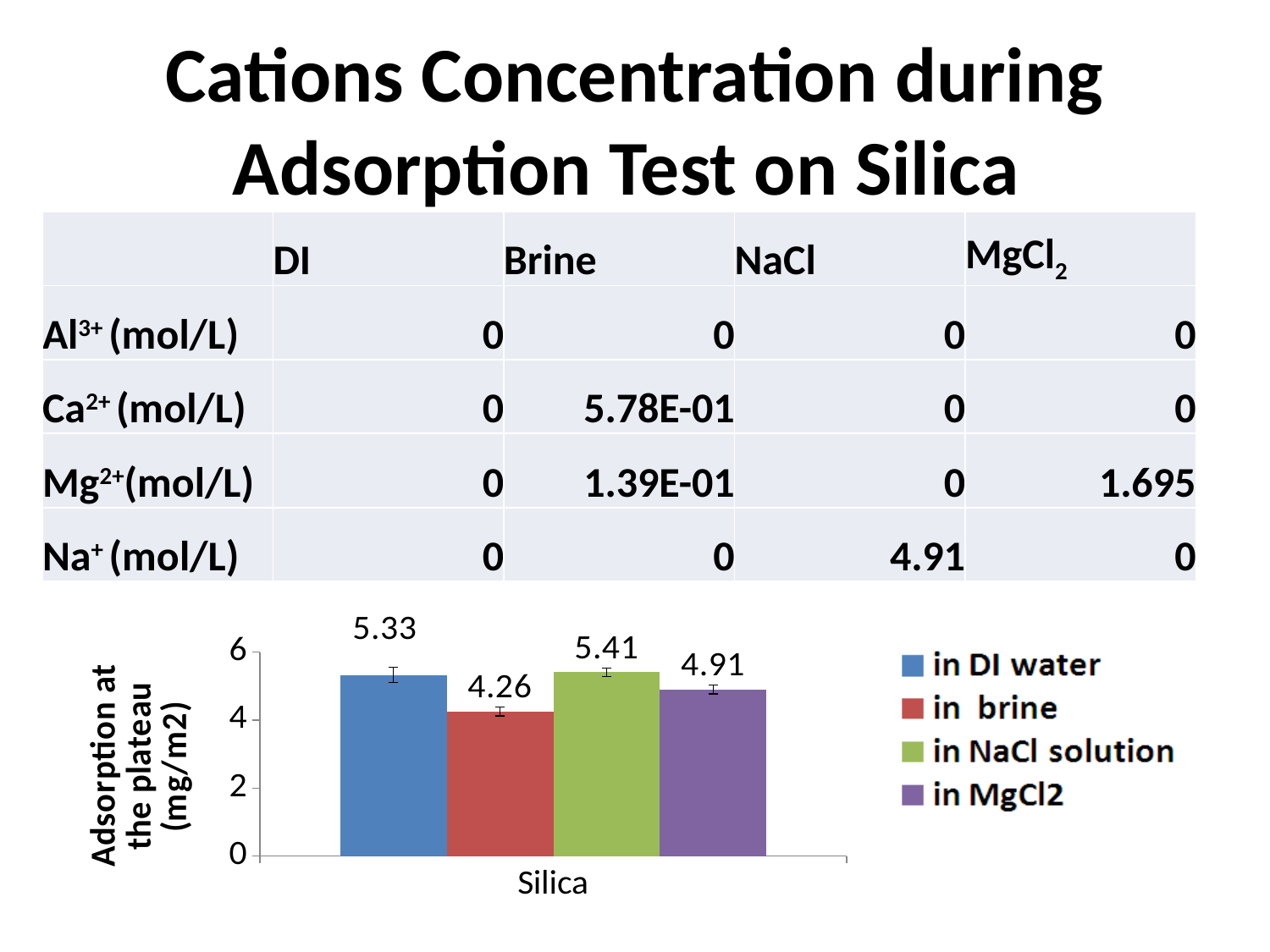
What kind of chart is shown on the slide? bar chart What is the difference between the adsorption in DI water and in brine? 1.07 What is the difference between the adsorption in NaCl solution and in MgCl2? 0.5 Which is larger, the adsorption in DI water or in MgCl2? in DI water What is the adsorption at the plateau for silica in DI water? 5.33 What is the adsorption at the plateau for silica in MgCl2? 4.91 How many series does the chart legend list? 4 What is the adsorption at the plateau for silica in brine? 4.26 Which series has the highest adsorption at the plateau? in NaCl solution What is the adsorption at the plateau for silica in NaCl solution? 5.41 What is the label on the y axis of the chart? Adsorption at the plateau (mg/m2) Which series has the lowest adsorption at the plateau? in brine